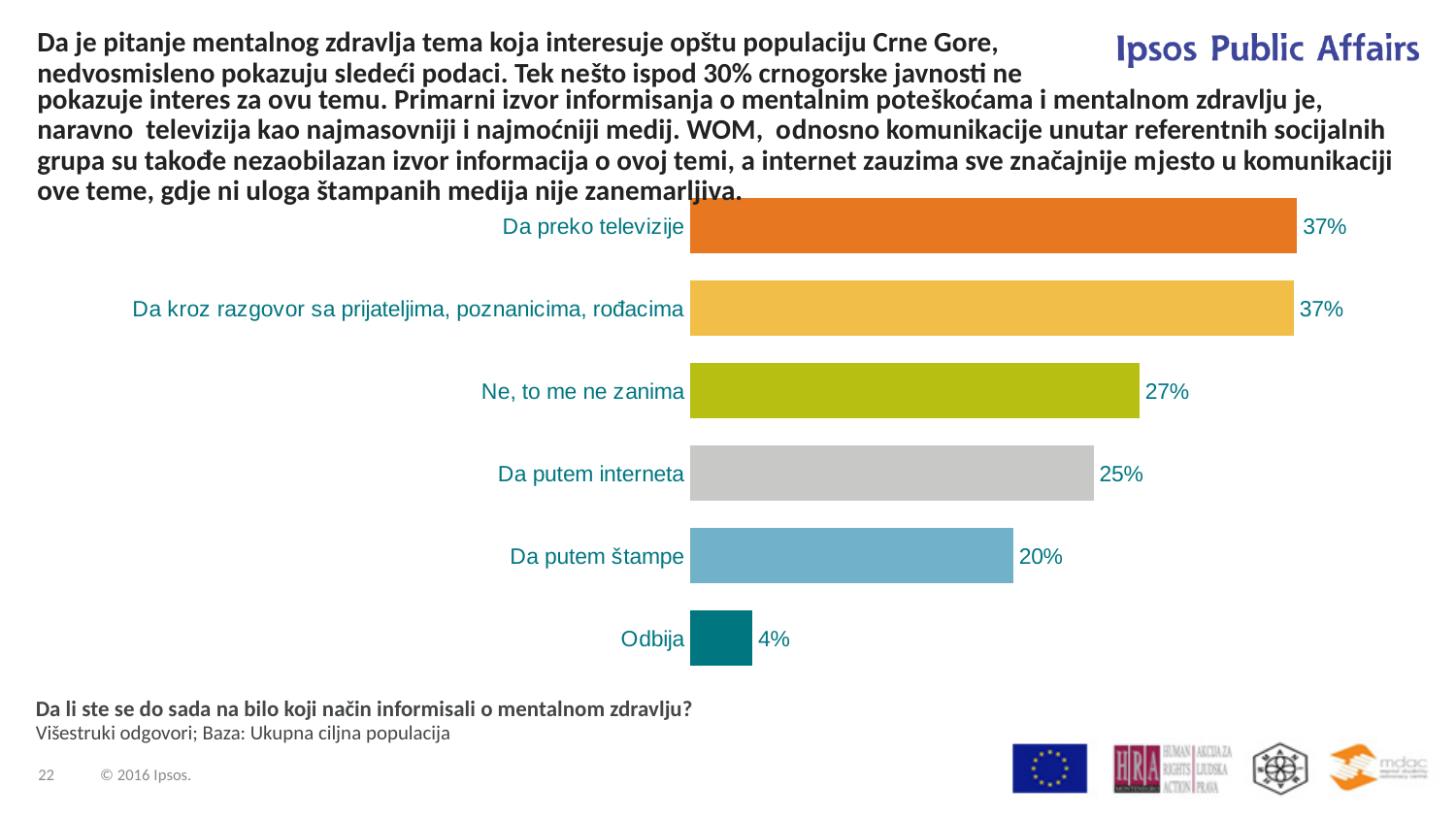
Which category has the lowest value? Odbija How many categories are shown in the chart? 6 What is the value for "Da putem štampe"? 20% What kind of chart is shown on the slide? Bar chart What is the difference between the values for "Da preko televizije" and "Da putem štampe"? 17% What is the value for "Odbija"? 4% What is the difference between the values for "Ne, to me ne zanima" and "Odbija"? 23% What is the value for "Ne, to me ne zanima"? 27% What colour is the bar for "Da preko televizije"? Orange What is the value for "Da putem interneta"? 25% Which is larger, the value for "Da putem interneta" or the value for "Da putem štampe"? Da putem interneta What is the value for "Da preko televizije"? 37%